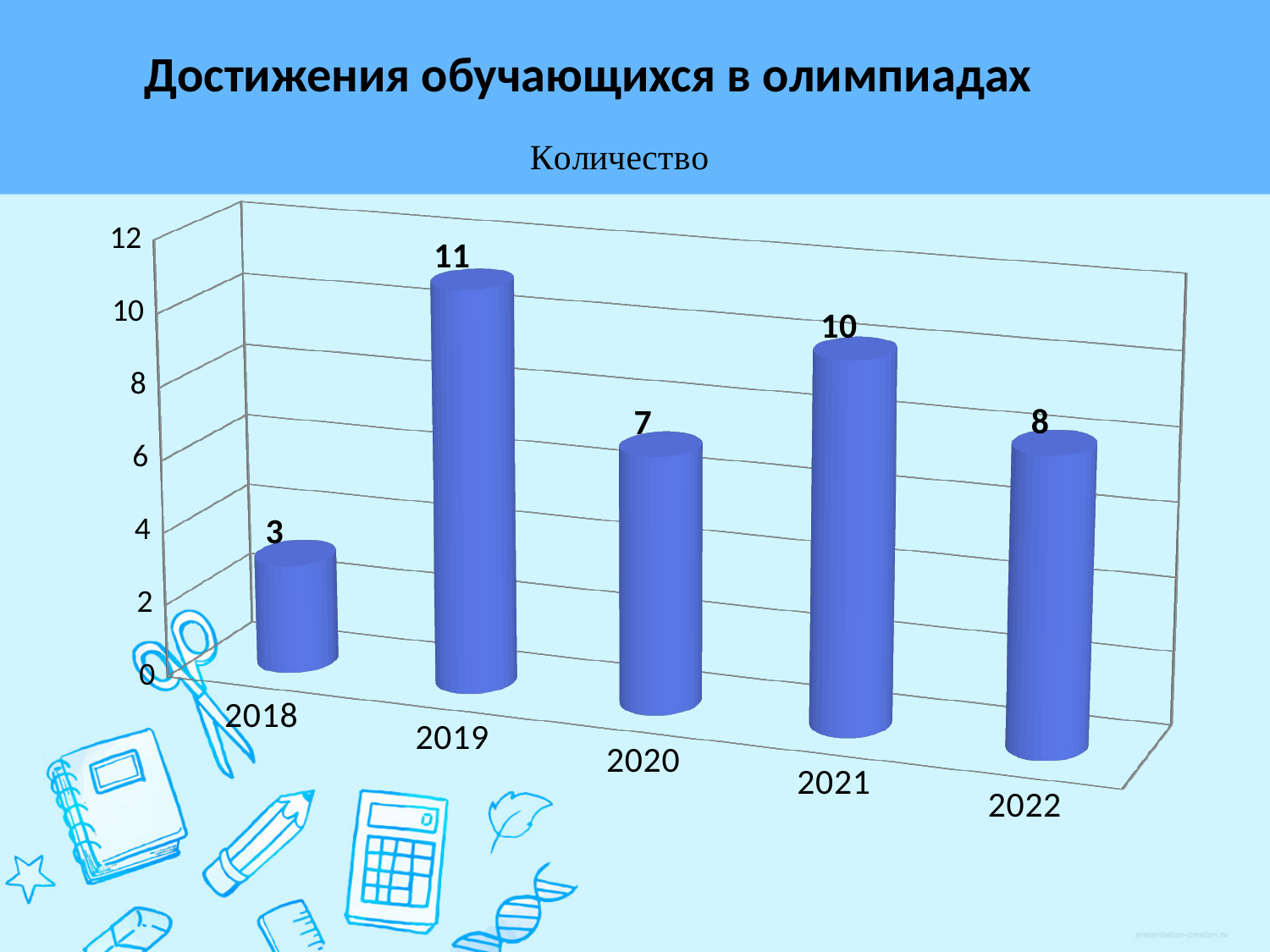
What is the value for 2022? 8 Which is larger, the value for 2021 or the value for 2022? 2021 What is the difference between the values for 2021 and 2018? 7 Which year has the highest value? 2019 What kind of chart is shown on the slide? bar chart What is the value for 2018? 3 What is the value for 2019? 11 How many years are shown on the x axis? 5 Is the value for 2020 greater or less than 6? greater What is the difference between the values for 2019 and 2020? 4 What is the title of the chart? Количество Which year has the lowest value? 2018